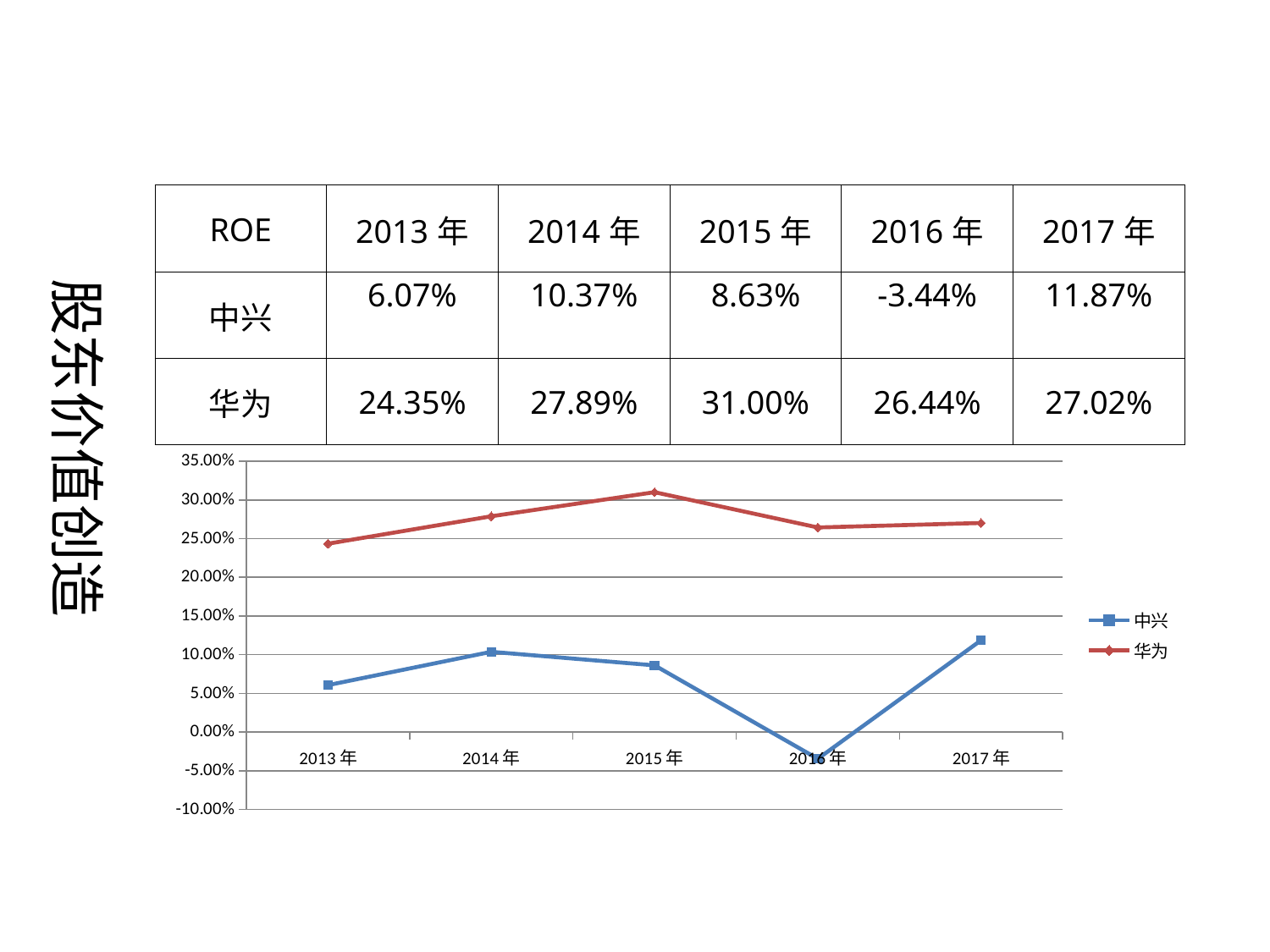
What kind of chart is shown on the slide? line chart In which year is the ROE for 中兴 lowest? 2016 年 What is the difference between the ROE of 华为 and 中兴 in 2013 年? 18.28% How many years are plotted along the x axis of the chart? 5 What is the ROE value for 中兴 in 2016 年? -3.44% What is the ROE value for 华为 in 2015 年? 31.00% In which year is the ROE for 华为 highest? 2015 年 Is the ROE for 华为 in 2016 年 greater or less than 25.00%? greater Does the ROE for 华为 rise or fall from 2015 年 to 2016 年? fall How many series does the chart legend list? 2 Which series has the higher ROE in 2017 年, 中兴 or 华为? 华为 What colour is the line for 中兴 in the chart? blue